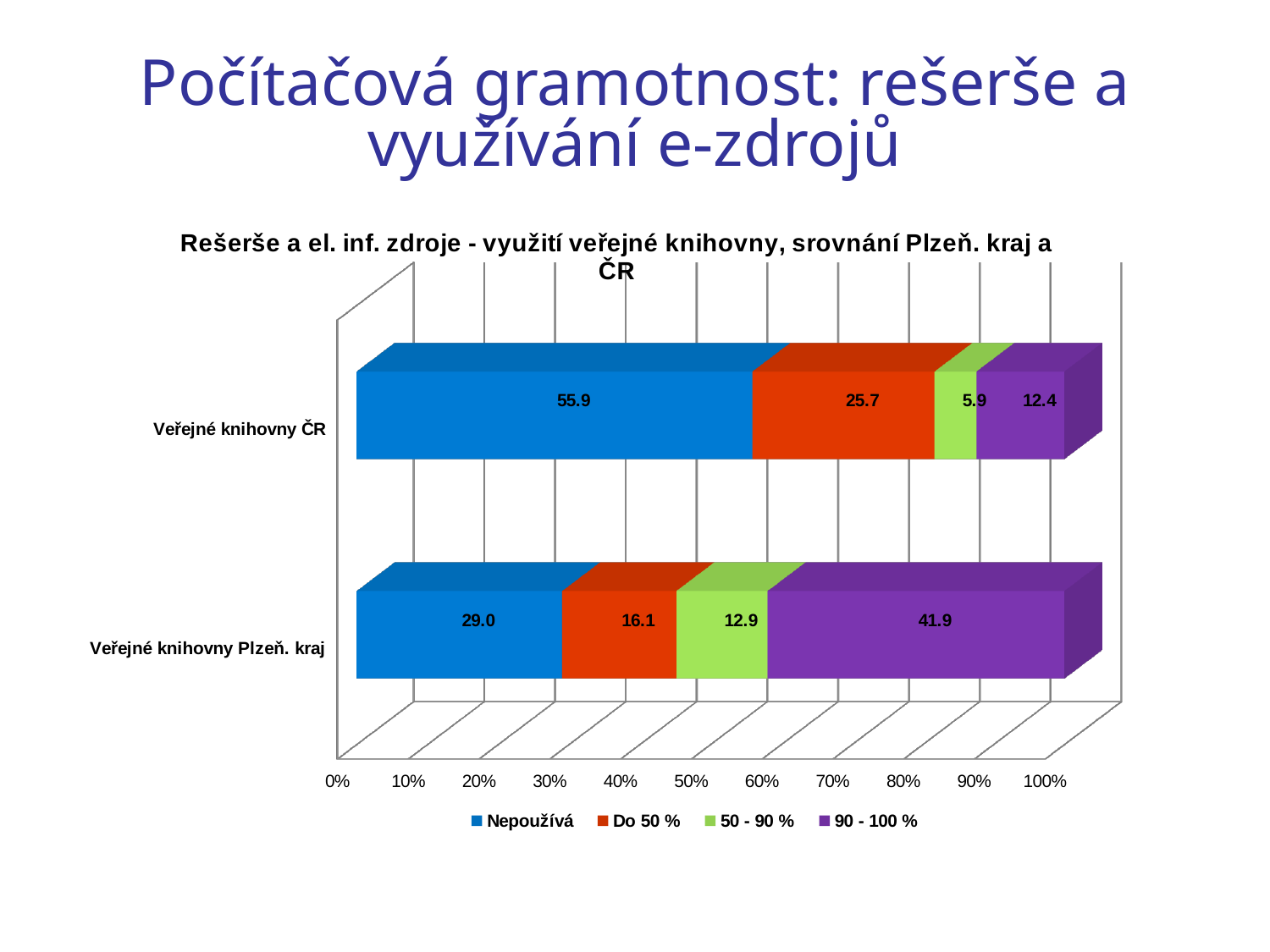
Which category has the larger "90 - 100 %" value, Veřejné knihovny ČR or Veřejné knihovny Plzeň. kraj? Veřejné knihovny Plzeň. kraj Which series has the smallest value for Veřejné knihovny ČR? 50 - 90 % What is the value of "50 - 90 %" for Veřejné knihovny ČR? 5.9 What is the value of "Do 50 %" for Veřejné knihovny Plzeň. kraj? 16.1 What is the difference between the "Nepoužívá" values for Veřejné knihovny ČR and Veřejné knihovny Plzeň. kraj? 26.9 How many categories are shown on the chart? 2 What colour represents the "Do 50 %" series? Red How many series does the legend list? 4 What is the value of "Nepoužívá" for Veřejné knihovny ČR? 55.9 Which series has the largest value for Veřejné knihovny Plzeň. kraj? 90 - 100 % What kind of chart is shown on the slide? Stacked bar chart What is the value of "90 - 100 %" for Veřejné knihovny Plzeň. kraj? 41.9